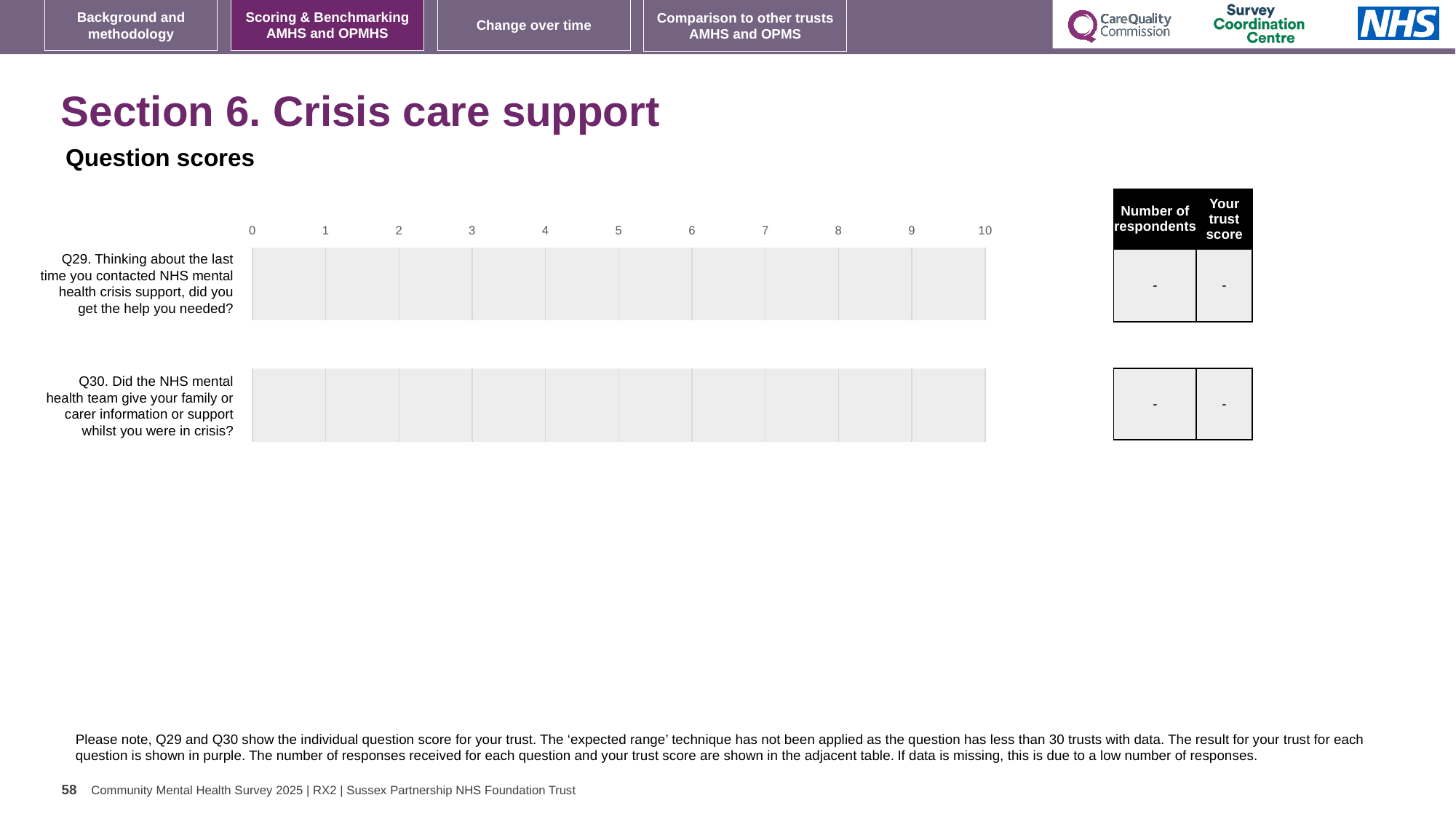
What is the minimum value shown on the chart's horizontal axis? 0 Which question numbers are shown as categories on the chart? Q29 and Q30 Are any bar values plotted for Q29 or Q30 on the chart? No What is the maximum value shown on the chart's horizontal axis? 10 What is the 'Your trust score' value shown for Q29 in the adjacent table? - What is the 'Number of respondents' value shown for Q30 in the adjacent table? - How many questions (categories) are listed on the chart? 2 What kind of chart is shown on the slide? Bar chart